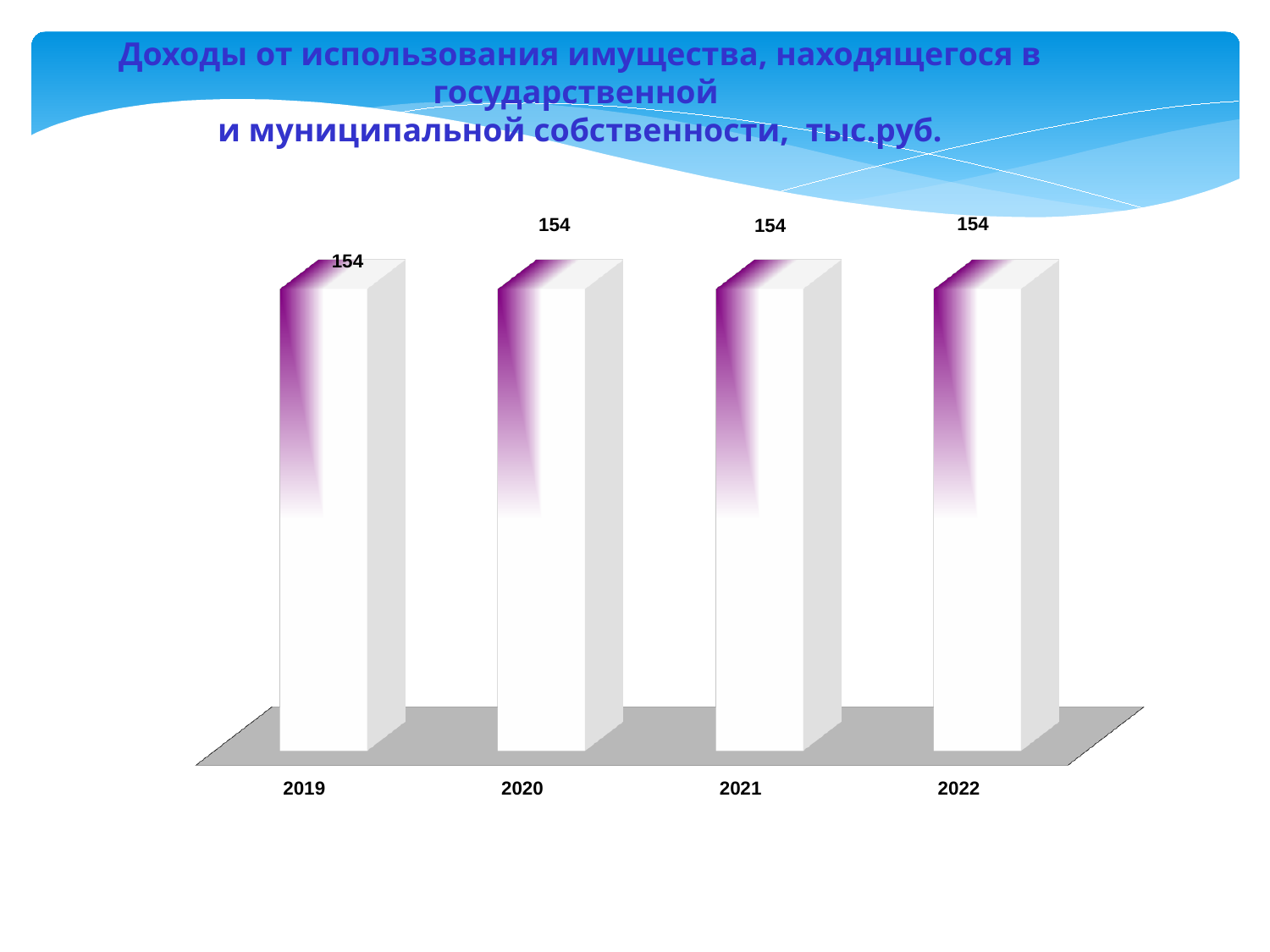
What is the difference between the values for 2019 and 2022? 0 What is the difference between the values for 2020 and 2021? 0 What kind of chart is shown on the slide? Bar chart How many years are shown on the chart? 4 What is the value for 2019? 154 Which year is the first category on the x axis? 2019 What unit of measurement is given in the chart title? тыс.руб. What is the value for 2020? 154 Do the values rise, fall, or stay the same from 2019 to 2022? Stay the same What is the value for 2022? 154 What is the value for 2021? 154